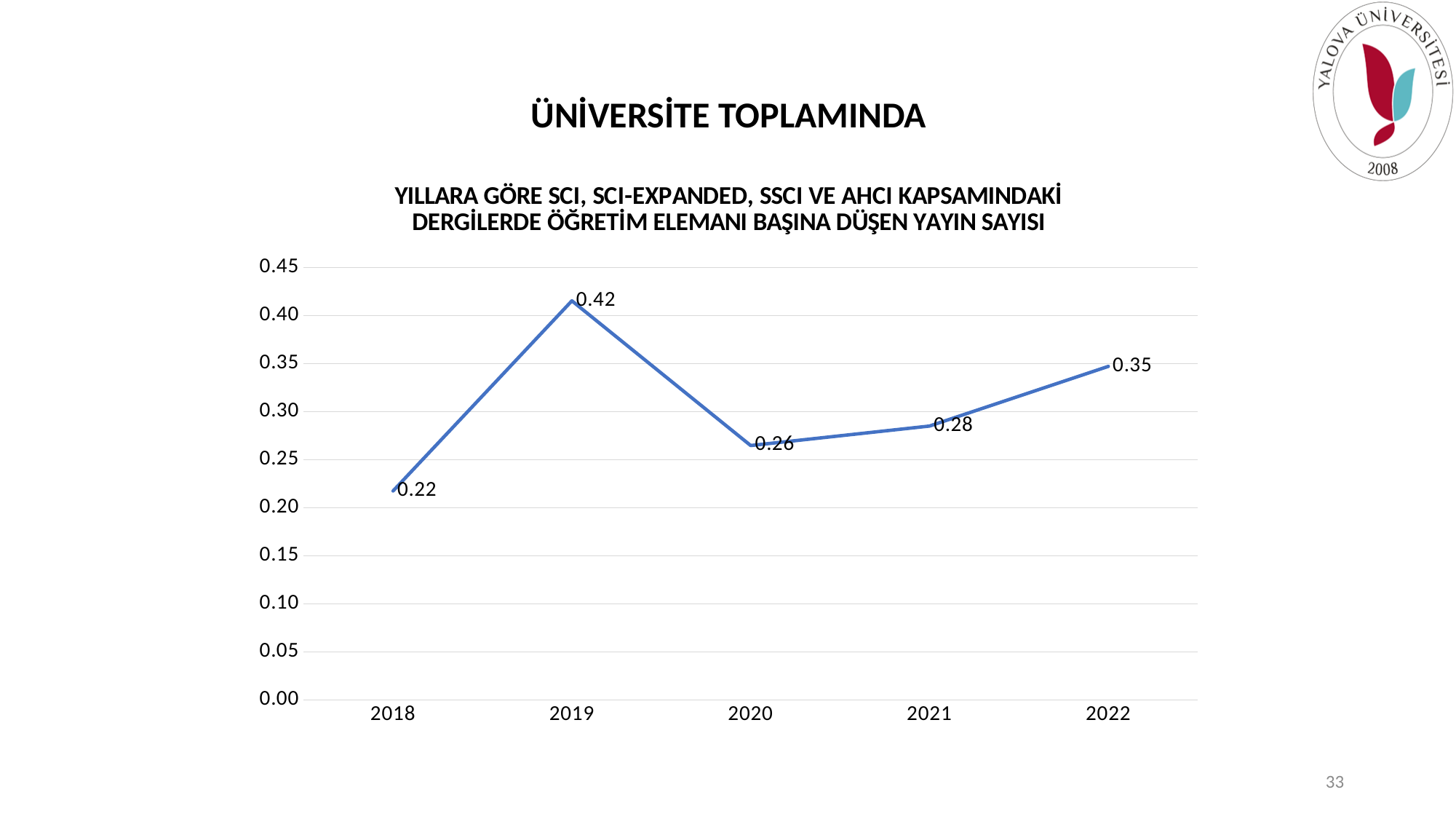
What kind of chart is shown on the slide? line chart How many years are plotted on the chart? 5 Which year has the highest value? 2019 Which year has the lowest value? 2018 What is the difference between the values for 2019 and 2020? 0.16 What is the value for 2022? 0.35 What is the difference between the values for 2022 and 2021? 0.07 Which is larger, the value for 2020 or the value for 2022? 2022 Do the values rise or fall from 2020 to 2022? rise What is the value for 2019? 0.42 What is the value for 2018? 0.22 Is the value for 2021 greater or less than 0.30? less